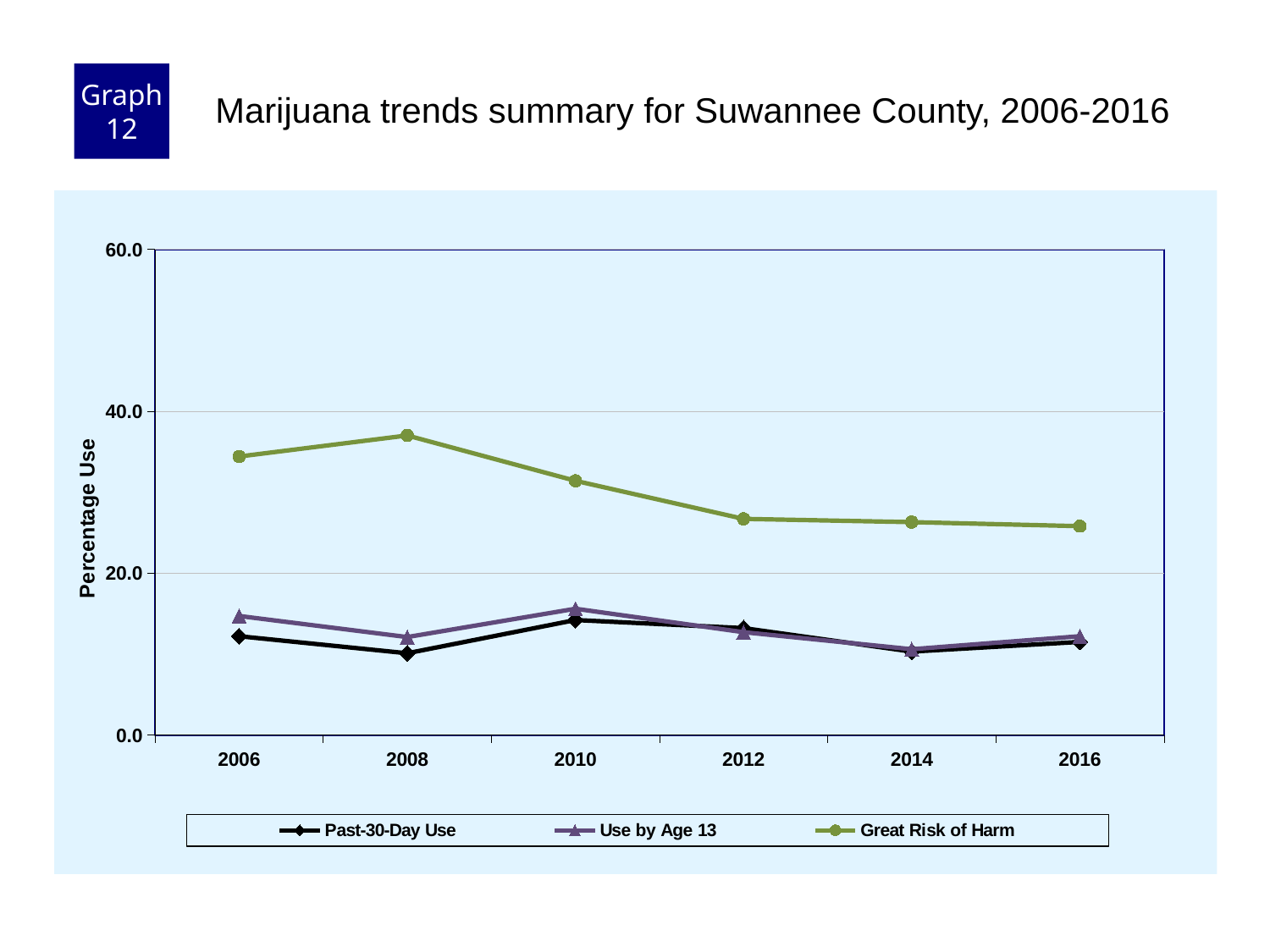
Is the value for Great Risk of Harm in 2016 greater or less than 20.0? greater Which series is drawn in green? Great Risk of Harm Is the value for Great Risk of Harm in 2008 greater or less than 40.0? less What kind of chart is shown on the slide? line chart Does the Great Risk of Harm series rise or fall from 2008 to 2016? fall What is the label on the y axis? Percentage Use In 2006, which is larger: Great Risk of Harm or Past-30-Day Use? Great Risk of Harm How many years are plotted along the x axis? 6 In which year is the Use by Age 13 series at its lowest? 2014 In which year is the Great Risk of Harm series at its highest? 2008 Is the value for Past-30-Day Use in 2008 greater or less than 20.0? less How many series does the legend list? 3